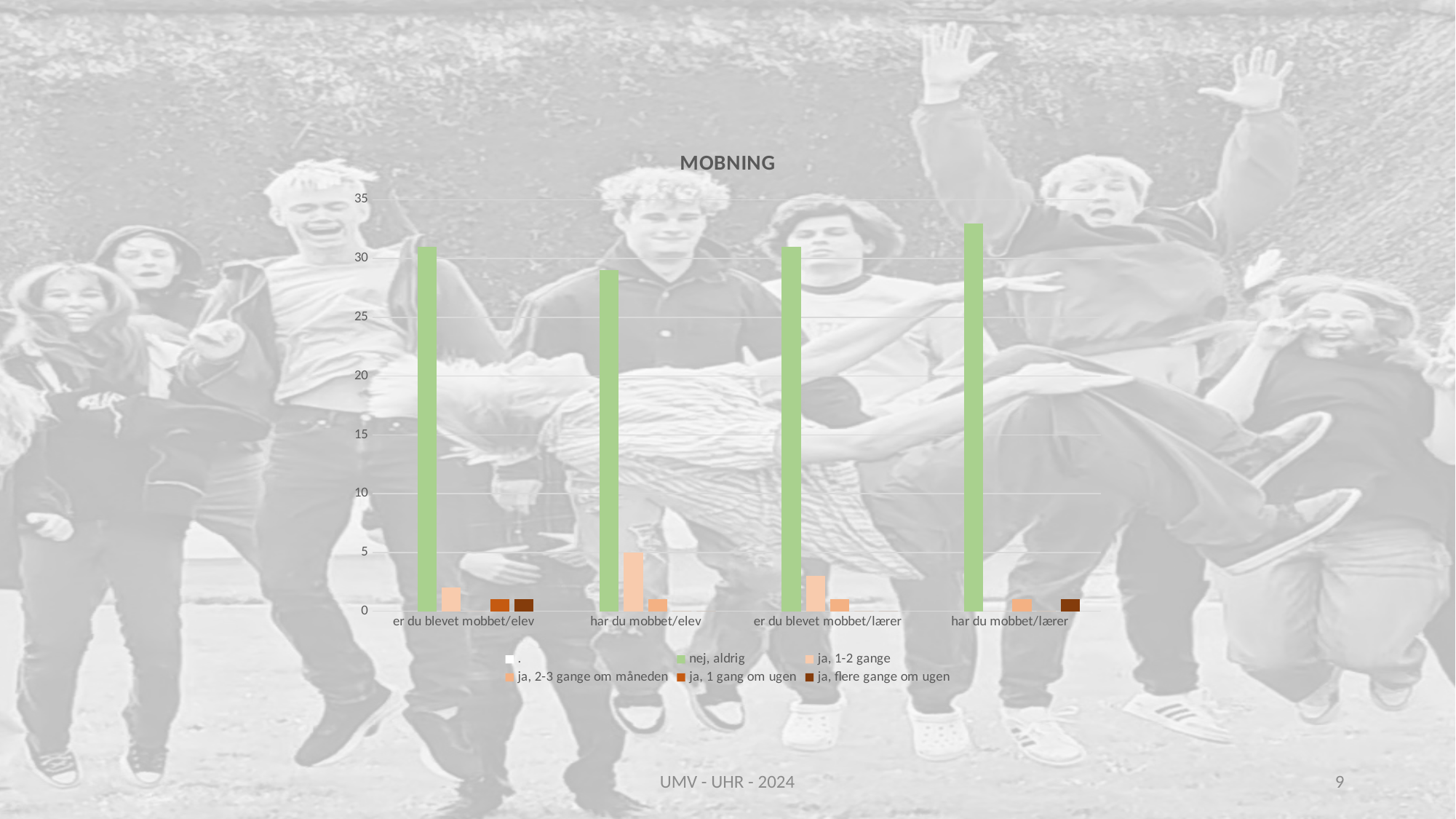
Which category has the lowest value for the series "nej, aldrig"? har du mobbet/elev Is the value of "nej, aldrig" for "har du mobbet/elev" greater or less than 30? less How many categories are shown on the x axis of the chart? 4 Which category has the highest value for the series "nej, aldrig"? har du mobbet/lærer How many series does the chart's legend list? 6 What is the title of the chart? MOBNING What kind of chart is shown on the slide? bar chart For the series "ja, 1-2 gange", which is larger: the value for "har du mobbet/elev" or the value for "er du blevet mobbet/elev"? har du mobbet/elev Which series is shown in green in the chart? nej, aldrig Is the value of "nej, aldrig" for "har du mobbet/lærer" greater or less than 30? greater Is the value of "nej, aldrig" for "er du blevet mobbet/elev" greater or less than 25? greater